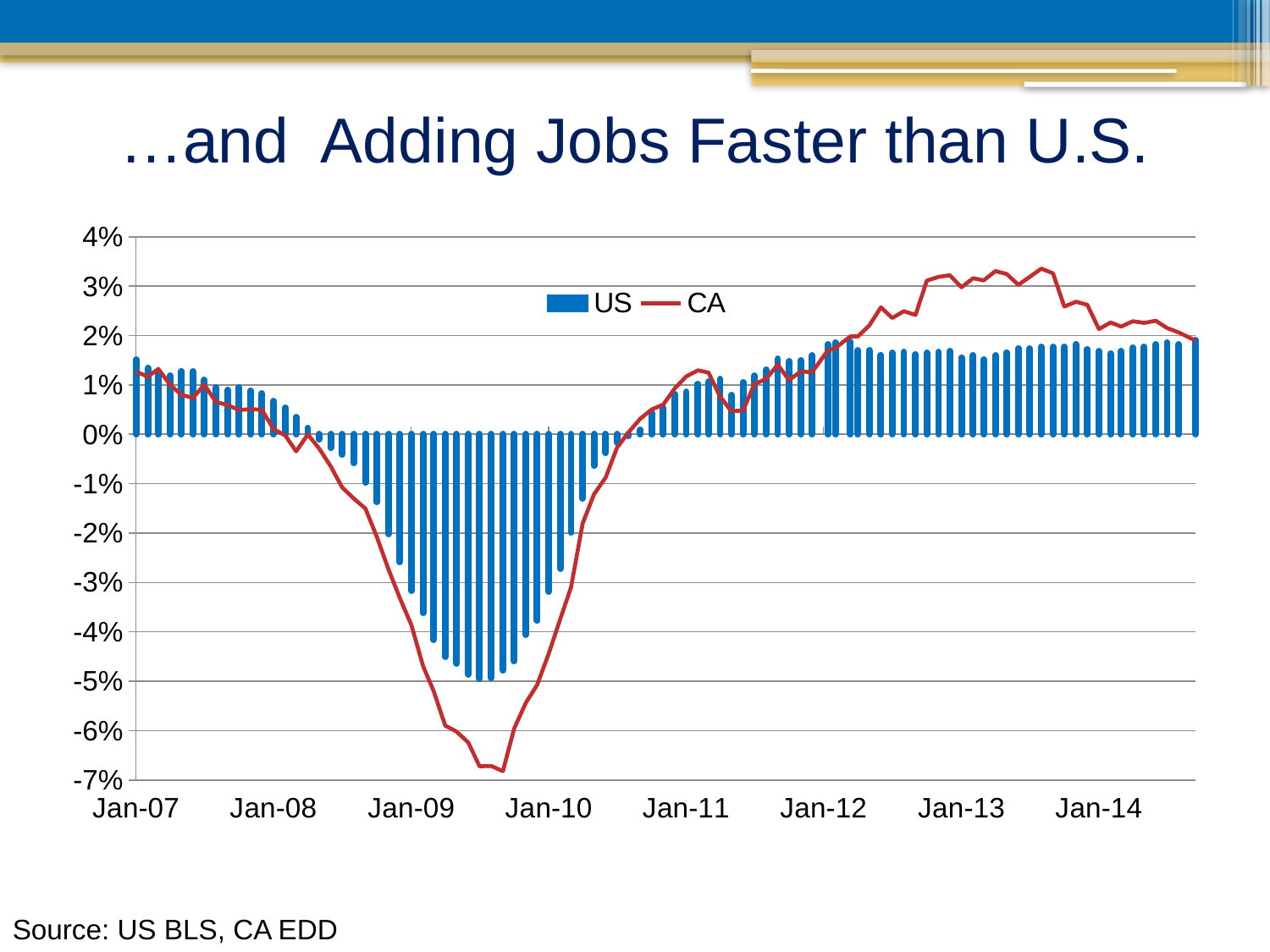
At Jan-13, which series has the higher value, US or CA? CA What kind of chart is used for the CA series? Line chart Is the lowest value of the CA line greater or less than -6%? less Is the lowest value of the US bars greater or less than -4%? less What is the title of the slide containing the chart? …and Adding Jobs Faster than U.S. Is the US value at Jan-14 greater or less than 2%? less How many series does the chart legend list? 2 What are the two series named in the chart legend? US and CA What kind of chart is used for the US series? Bar chart How many year labels are shown on the x axis? 8 Does the CA line rise or fall between Jan-13 and Jan-14? fall